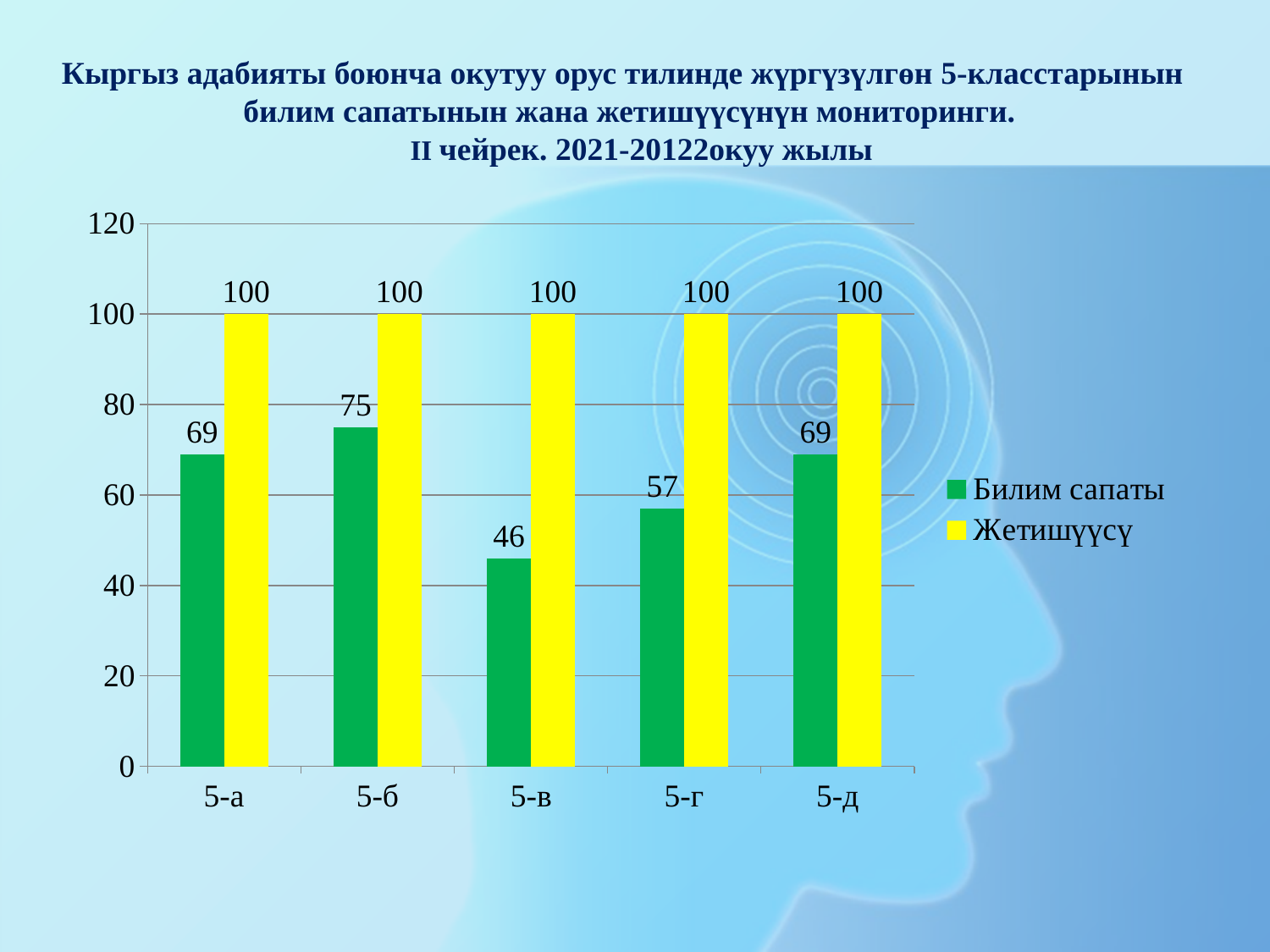
Which class has the highest Билим сапаты value? 5-б What is the difference between the Билим сапаты values for 5-б and 5-в? 29 What is the value of Билим сапаты for 5-б? 75 What colour are the Жетишүүсү bars? yellow What is the value of Жетишүүсү for 5-г? 100 How many classes are shown on the x axis? 5 How many series does the legend list? 2 What kind of chart is shown on the slide? bar chart Is the Билим сапаты value for 5-а greater or less than 60? greater Which class has the lowest Билим сапаты value? 5-в Which is larger, the Билим сапаты value for 5-г or for 5-д? 5-д What is the value of Билим сапаты for 5-в? 46